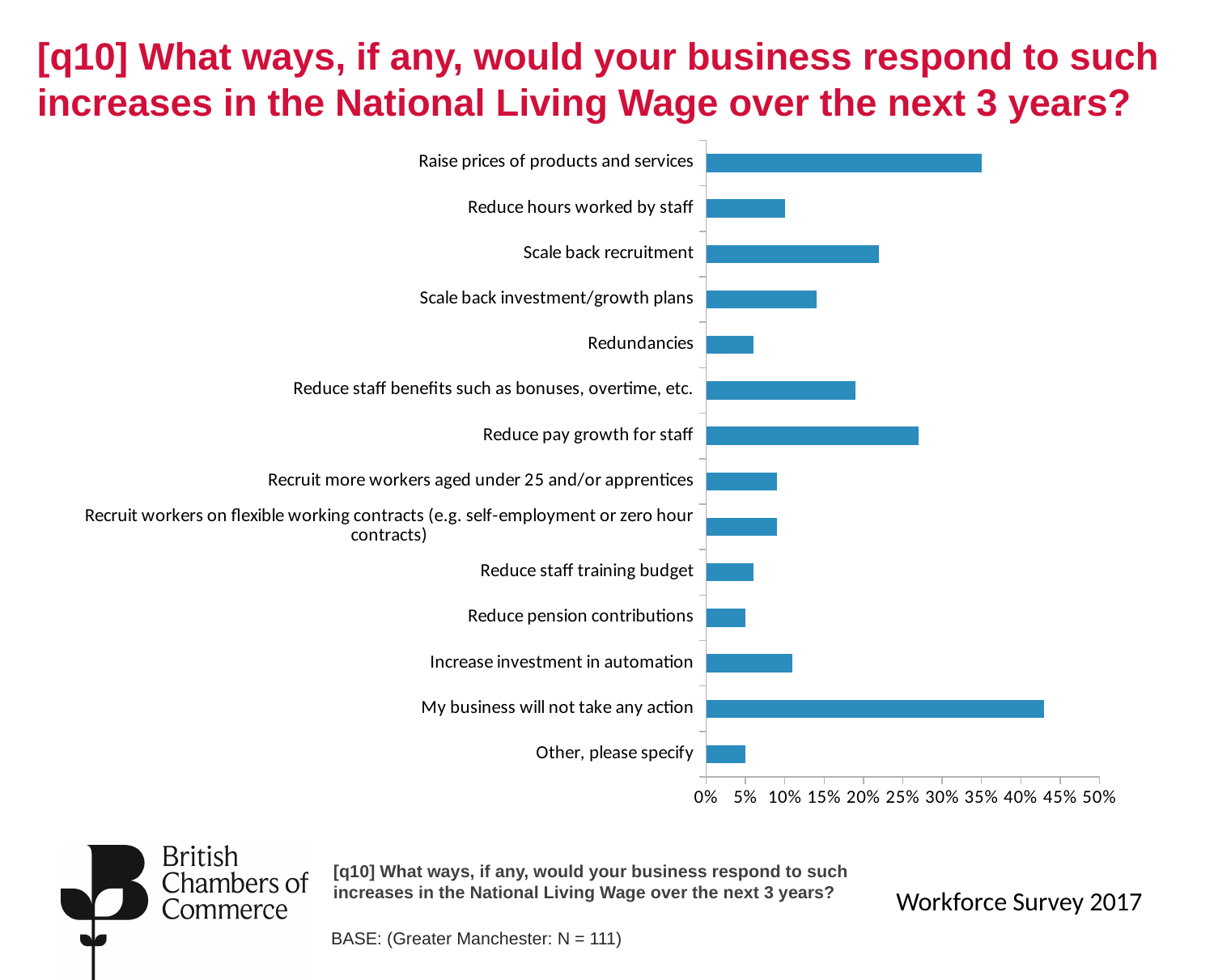
Which has the larger value: "Scale back recruitment" or "Scale back investment/growth plans"? Scale back recruitment Is the value for "Reduce pay growth for staff" greater or less than 25%? greater Is the value for "Raise prices of products and services" greater or less than 30%? greater Is the value for "Scale back investment/growth plans" greater or less than 10%? greater What is the highest percentage tick shown on the horizontal axis of the chart? 50% Which response category has the highest value in the chart? My business will not take any action What kind of chart is shown on the slide? Bar chart How many response categories are plotted in the chart? 14 Which has the larger value: "Raise prices of products and services" or "Reduce pay growth for staff"? Raise prices of products and services